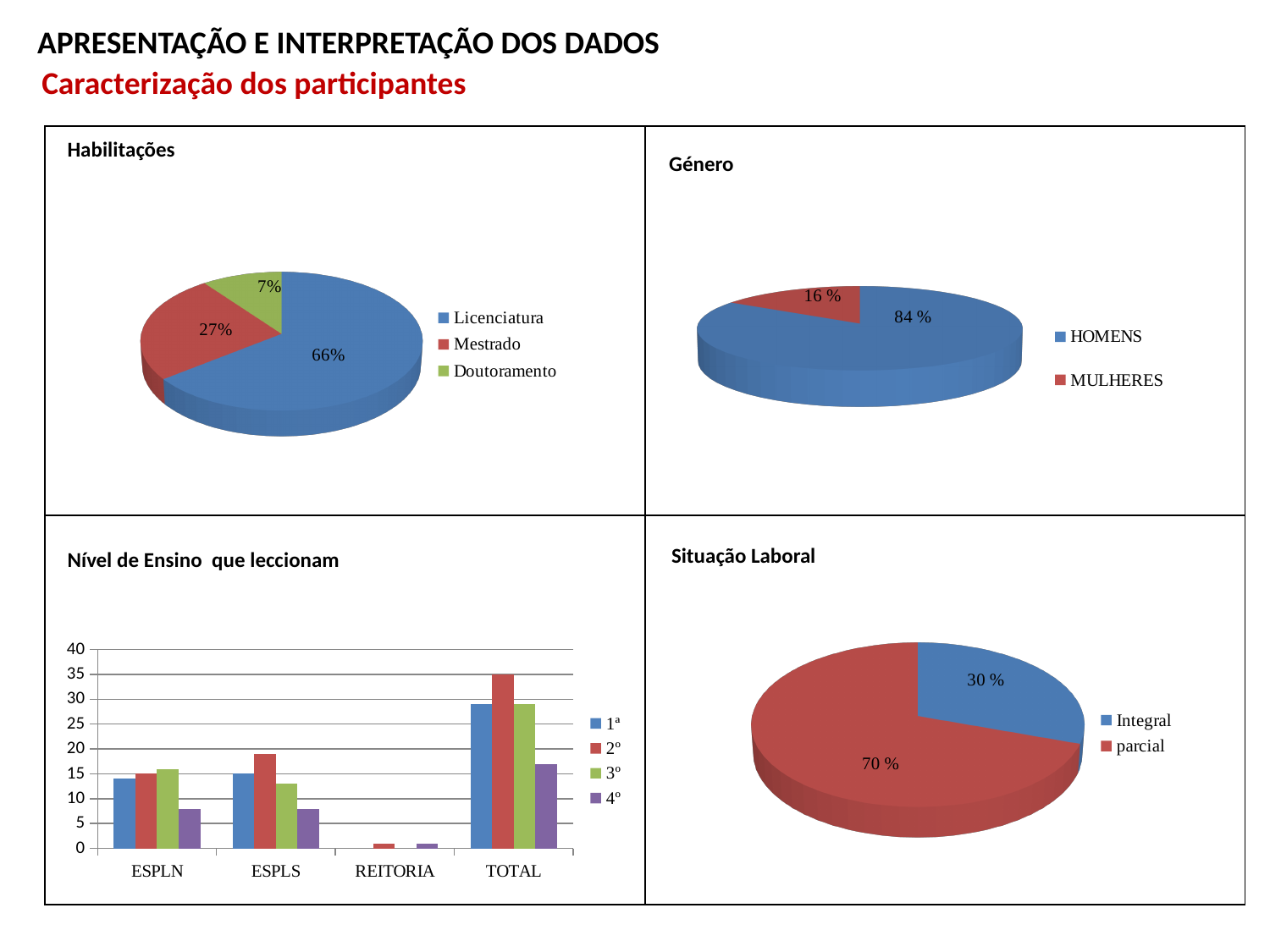
In the Situação Laboral pie chart, what percentage is shown for Integral? 30 % In the Habilitações pie chart, what is the difference between the Mestrado and Doutoramento shares? 20% How many series does the legend of the Nível de Ensino que leccionam chart list? 4 In the Habilitações pie chart, what percentage is shown for Licenciatura? 66% In the Género pie chart, what percentage is shown for MULHERES? 16 % In the Habilitações pie chart, which category has the largest share? Licenciatura In the Nível de Ensino que leccionam chart, is the value for 2º at TOTAL greater or less than 30? greater In the Género pie chart, which category has the smaller share? MULHERES In the Situação Laboral pie chart, which is larger, Integral or parcial? parcial In the Habilitações pie chart, what percentage is shown for Doutoramento? 7% In the Nível de Ensino que leccionam chart, is the value for 4º at ESPLN greater or less than 10? less What kind of chart is the Nível de Ensino que leccionam chart? bar chart